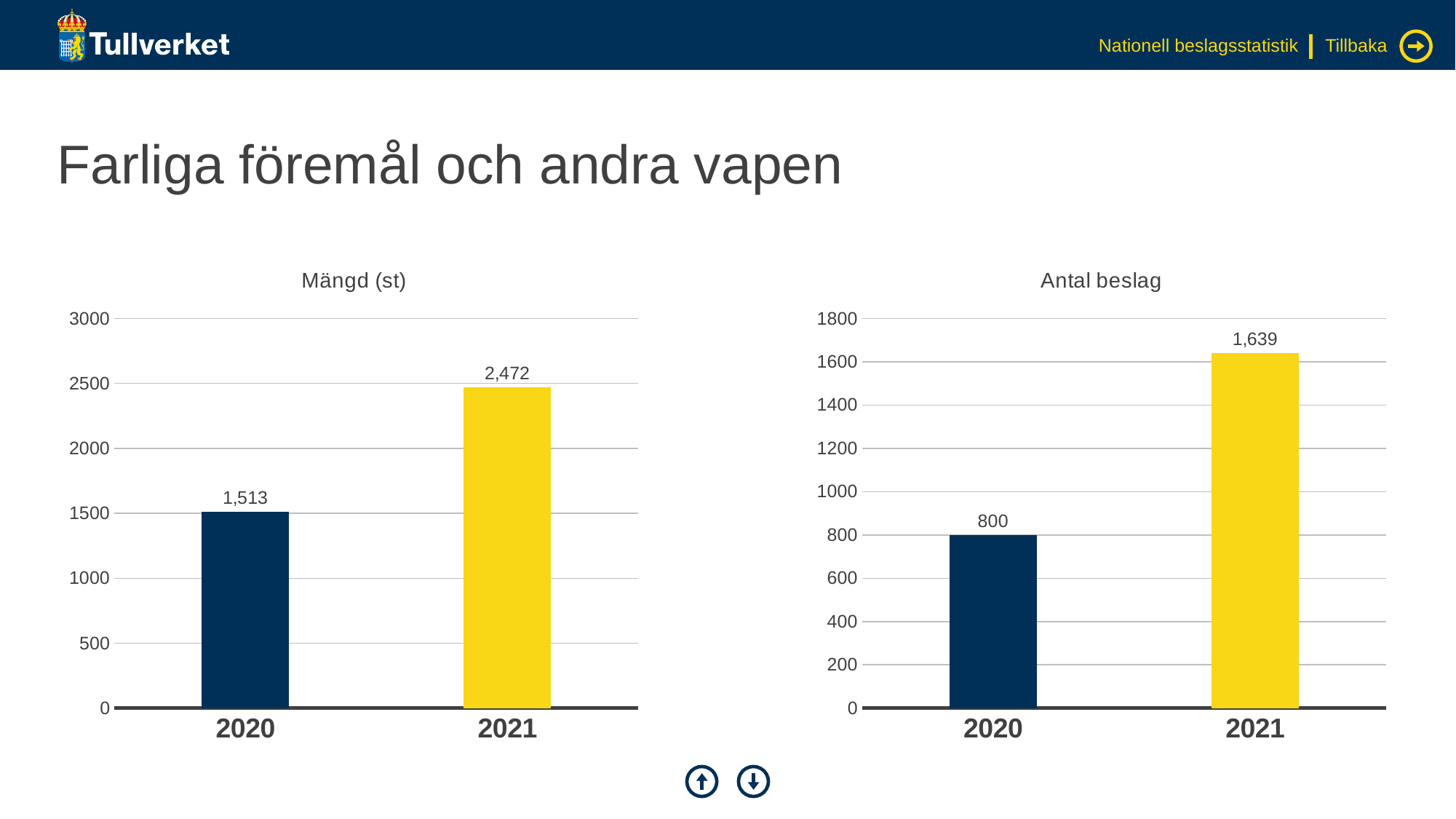
In the 'Antal beslag' chart, what is the value for 2020? 800 In the 'Mängd (st)' chart, do the values rise or fall from 2020 to 2021? rise In the 'Mängd (st)' chart, what is the value for 2021? 2,472 In the 'Antal beslag' chart, what is the value for 2021? 1,639 In the 'Antal beslag' chart, which year has the lowest value? 2020 In the 'Antal beslag' chart, is the value for 2021 greater or less than 1600? greater In the 'Mängd (st)' chart, how many years are shown on the x axis? 2 What kind of chart is the 'Antal beslag' chart? bar chart In the 'Mängd (st)' chart, what is the difference between the 2021 and 2020 values? 959 In the 'Mängd (st)' chart, which year has the highest value? 2021 In the 'Mängd (st)' chart, what is the value for 2020? 1,513 In the 'Antal beslag' chart, what is the difference between the 2021 and 2020 values? 839